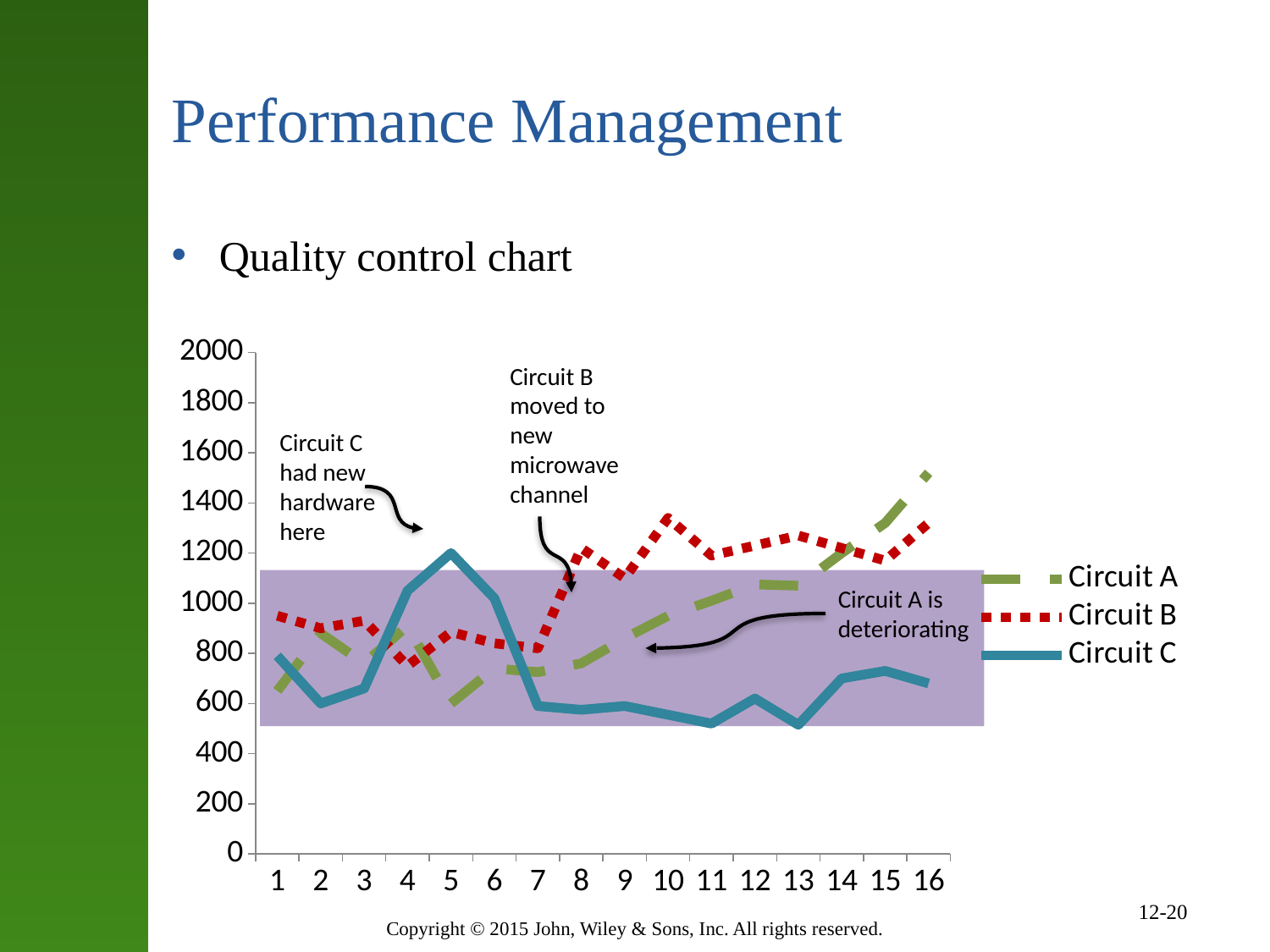
What kind of chart is shown on the slide? line chart Is the value for Circuit A at point 16 greater or less than 1400? greater Which series has the lowest value at point 11? Circuit C Which series are listed in the legend? Circuit A, Circuit B, Circuit C Is the value for Circuit C at point 5 greater or less than 1000? greater At point 5, which series has the higher value, Circuit C or Circuit A? Circuit C Is the value for Circuit B at point 10 greater or less than 1200? greater How many series does the legend list? 3 At point 16, which series has the higher value, Circuit A or Circuit B? Circuit A How many points are plotted along the x axis for each series? 16 Which series reaches the highest value anywhere on the chart? Circuit A